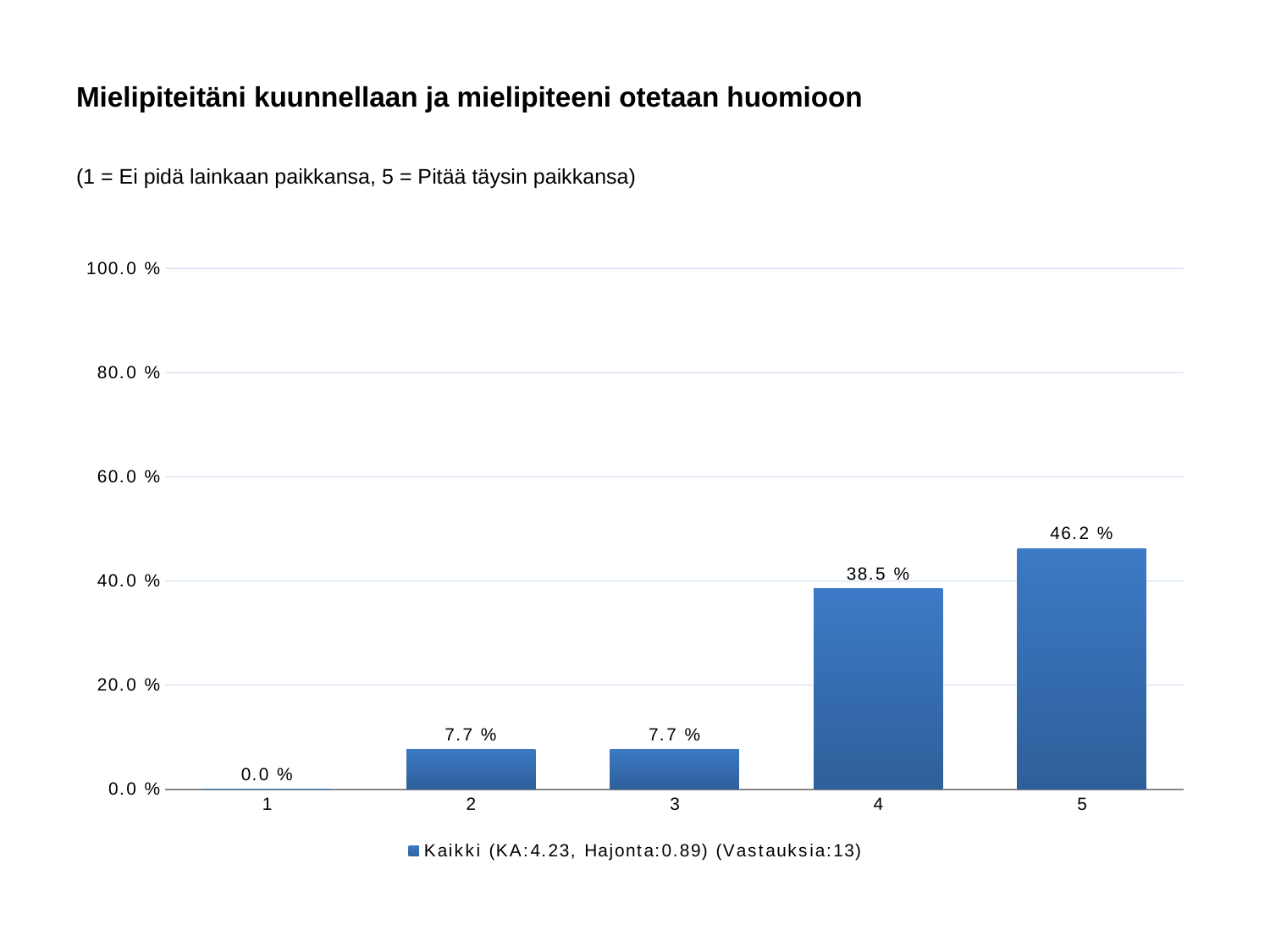
What is the value for category 4? 38.5 % Is the value for category 5 greater or less than 40.0 %? greater Which category has the lowest value? 1 Which is larger, the value for category 4 or the value for category 2? 4 What kind of chart is shown on the slide? bar chart What is the value for category 5? 46.2 % What is the difference between the values for category 5 and category 4? 7.7 % Which category has the highest value? 5 What is the value for category 1? 0.0 % What is the legend entry for the series? Kaikki (KA:4.23, Hajonta:0.89) (Vastauksia:13) How many series does the legend list? 1 How many categories are shown on the x axis? 5